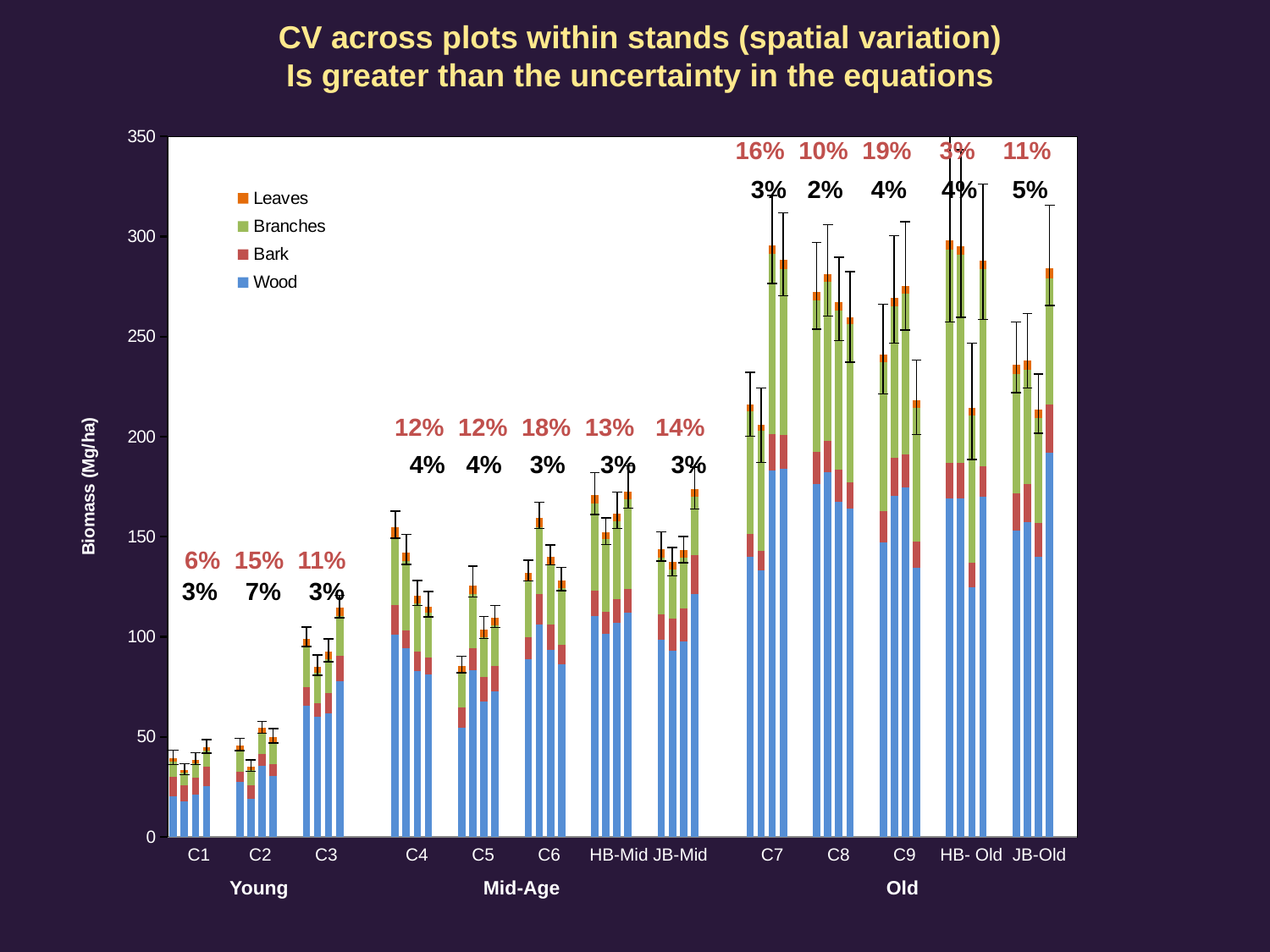
Are the total biomass values for the C8 bars greater or less than 250 Mg/ha? greater Which stand has the lowest red CV percentage? HB- Old Which stand has the highest red CV percentage? C9 What is the black percentage shown above the C2 stand? 7% How many series does the legend list? 4 Are the total biomass values for the C1 bars greater or less than 50 Mg/ha? less How many stand categories are labelled along the x axis? 13 What type of chart is shown on the slide? Stacked bar chart What are the four series listed in the legend? Leaves, Branches, Bark, Wood What is the red CV percentage shown above the C9 stand? 19% Which stand has taller stacked bars, C1 or C8? C8 What is the label of the y axis? Biomass (Mg/ha)